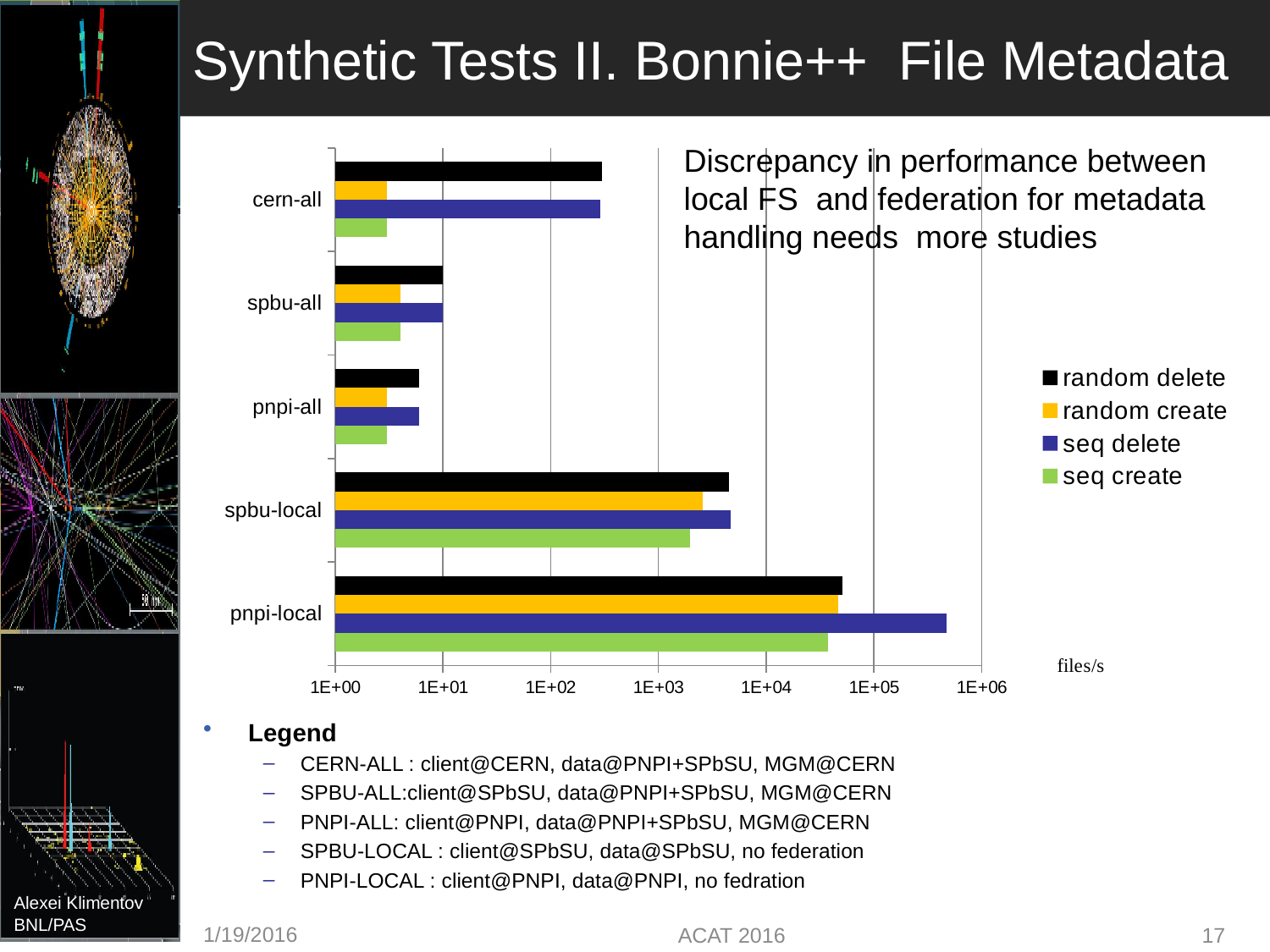
What unit label is shown next to the horizontal axis of the chart? files/s Is the seq delete value for pnpi-local greater or less than 1E+05? greater Which category has the lowest random delete value? pnpi-all Is the random create value for cern-all greater or less than 1E+01? less What kind of chart is shown on the slide? bar chart Which is larger, the random delete value for cern-all or for spbu-all? cern-all For pnpi-local, which is larger, seq delete or random delete? seq delete How many series does the chart's legend list? 4 Which category has the highest seq delete value? pnpi-local What colour represents the seq create series in the legend? green How many categories are plotted on the vertical axis of the chart? 5 Is the random delete value for spbu-local greater or less than 1E+03? greater